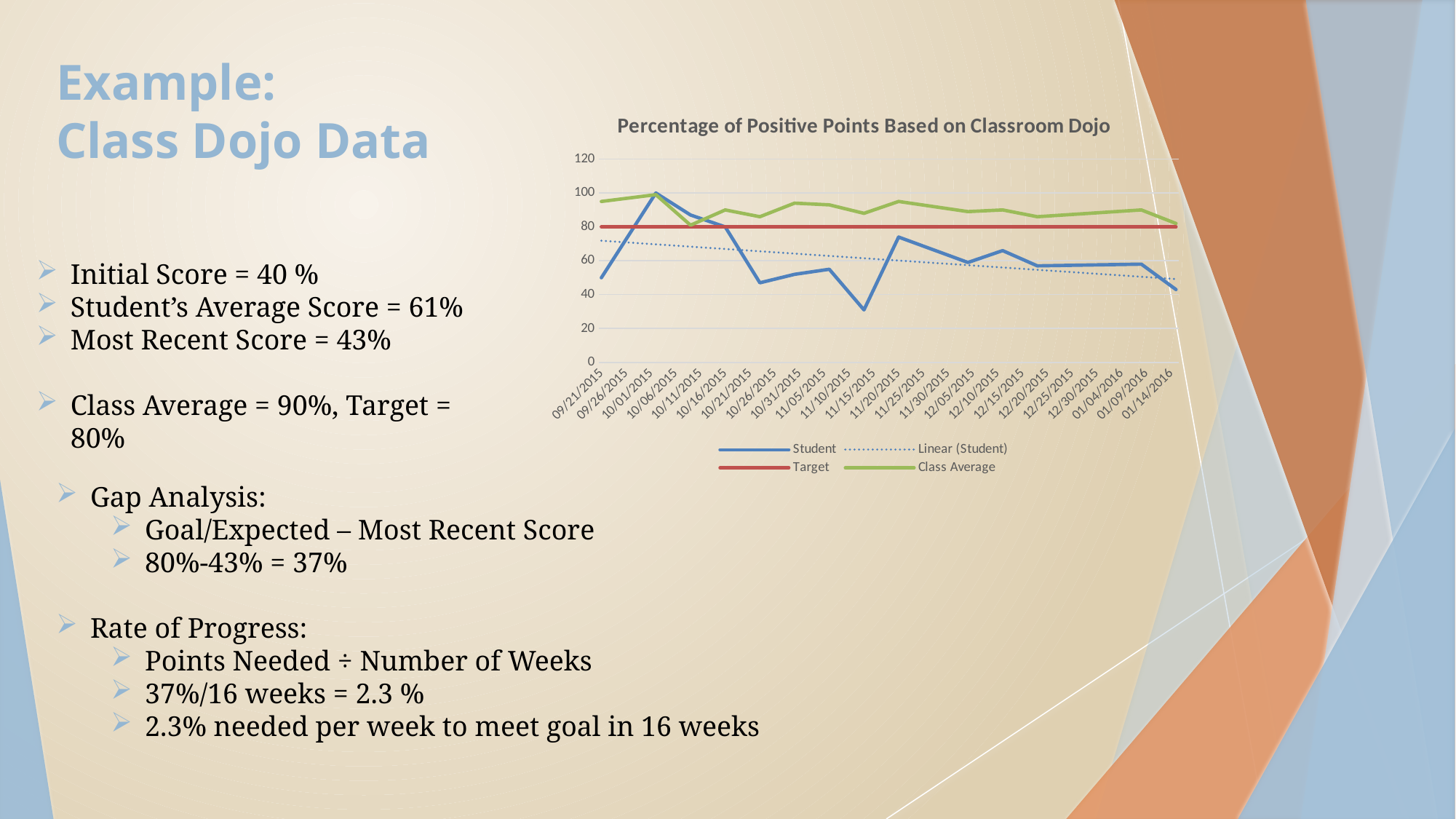
Is the Class Average value for 11/25/2015 greater or less than 80? greater How many series does the chart legend list? 4 Does the Linear (Student) trendline rise or fall from left to right? fall How many dates are shown on the x axis of the chart? 24 What is the title of the chart? Percentage of Positive Points Based on Classroom Dojo On 11/15/2015, which is larger, the Student value or the Class Average value? Class Average What value does the Target line sit at throughout the chart? 80 Is the Student value for 11/15/2015 greater or less than 40? less What kind of chart is shown on the slide? line chart Is the Student value for 10/21/2015 greater or less than 60? less